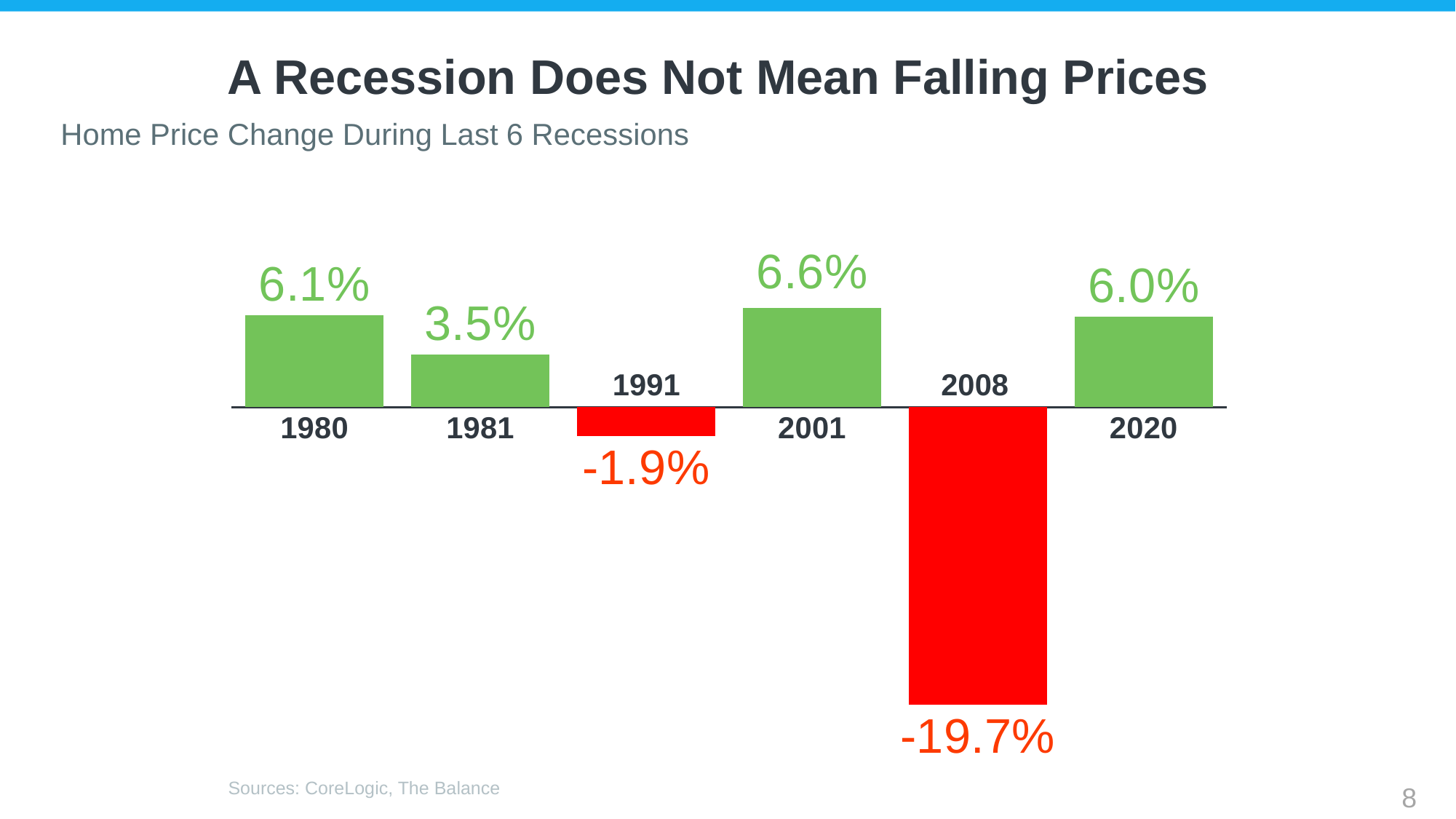
What was the home price change during the 1991 recession? -1.9% Which recession year shows the lowest home price change? 2008 What was the home price change during the 2008 recession? -19.7% What was the home price change during the 1980 recession? 6.1% What is the subtitle of the chart? Home Price Change During Last 6 Recessions What kind of chart is shown on the slide? Bar chart Which recession had a larger home price change, 1980 or 2020? 1980 How many recessions are shown in the chart? 6 What colour are the bars for recessions with negative home price change? Red What is the difference between the home price change in 2001 and in 1981? 3.1 percentage points How many of the recessions shown had a negative home price change? 2 Which recession year shows the highest home price change? 2001